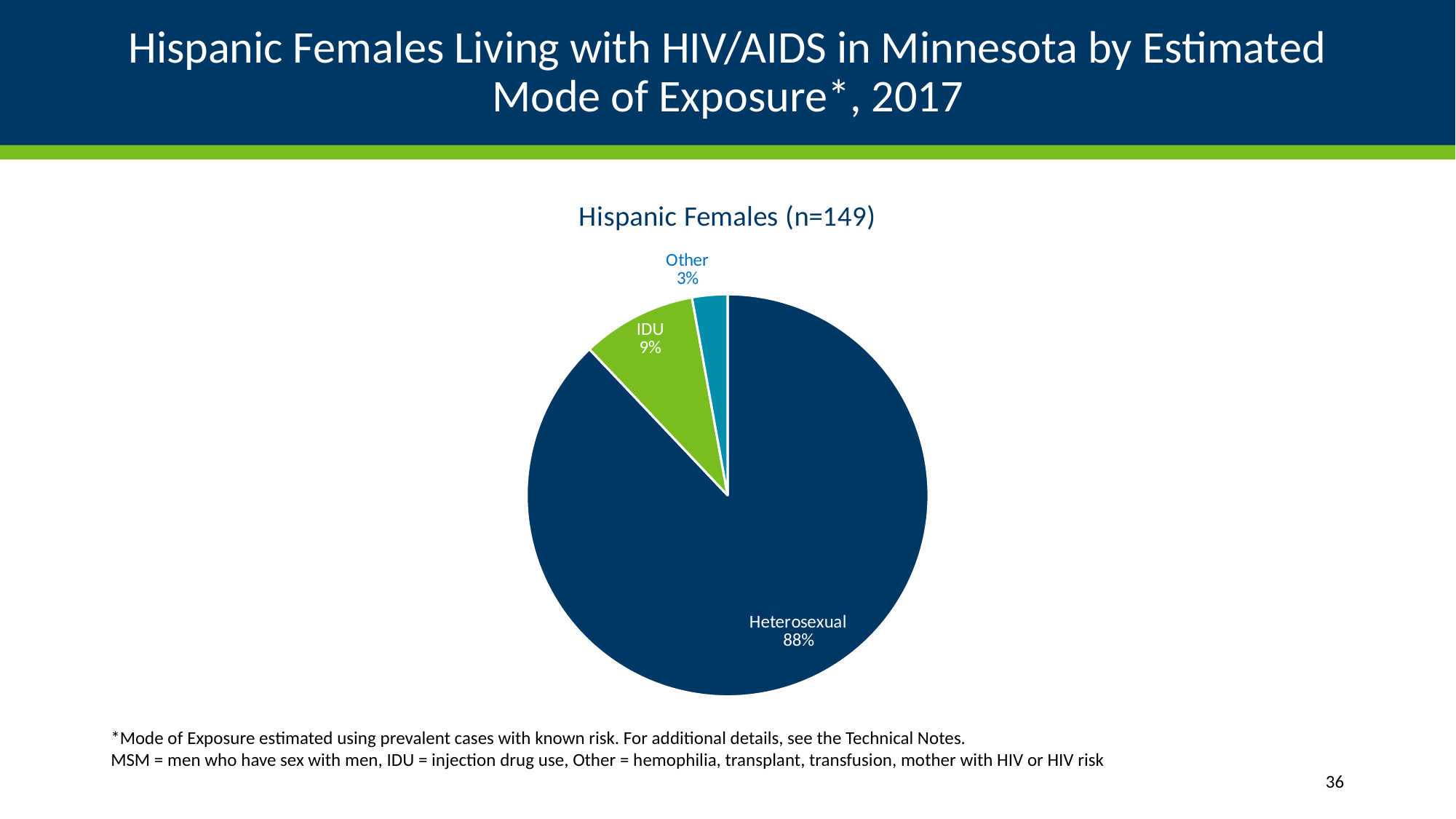
Which mode of exposure has the largest share of the pie? Heterosexual What colour is the IDU slice? green What is the title shown above the pie chart? Hispanic Females (n=149) Which mode of exposure has the smallest share of the pie? Other What type of chart is shown on the slide? pie chart What is the difference in percentage points between the Heterosexual and IDU shares? 79 What share of the pie does Heterosexual account for? 88% What share of the pie does IDU account for? 9% What share of the pie does Other account for? 3% What is the difference in percentage points between the IDU and Other shares? 6 Which has a larger share, IDU or Other? IDU How many slices does the pie chart have? 3